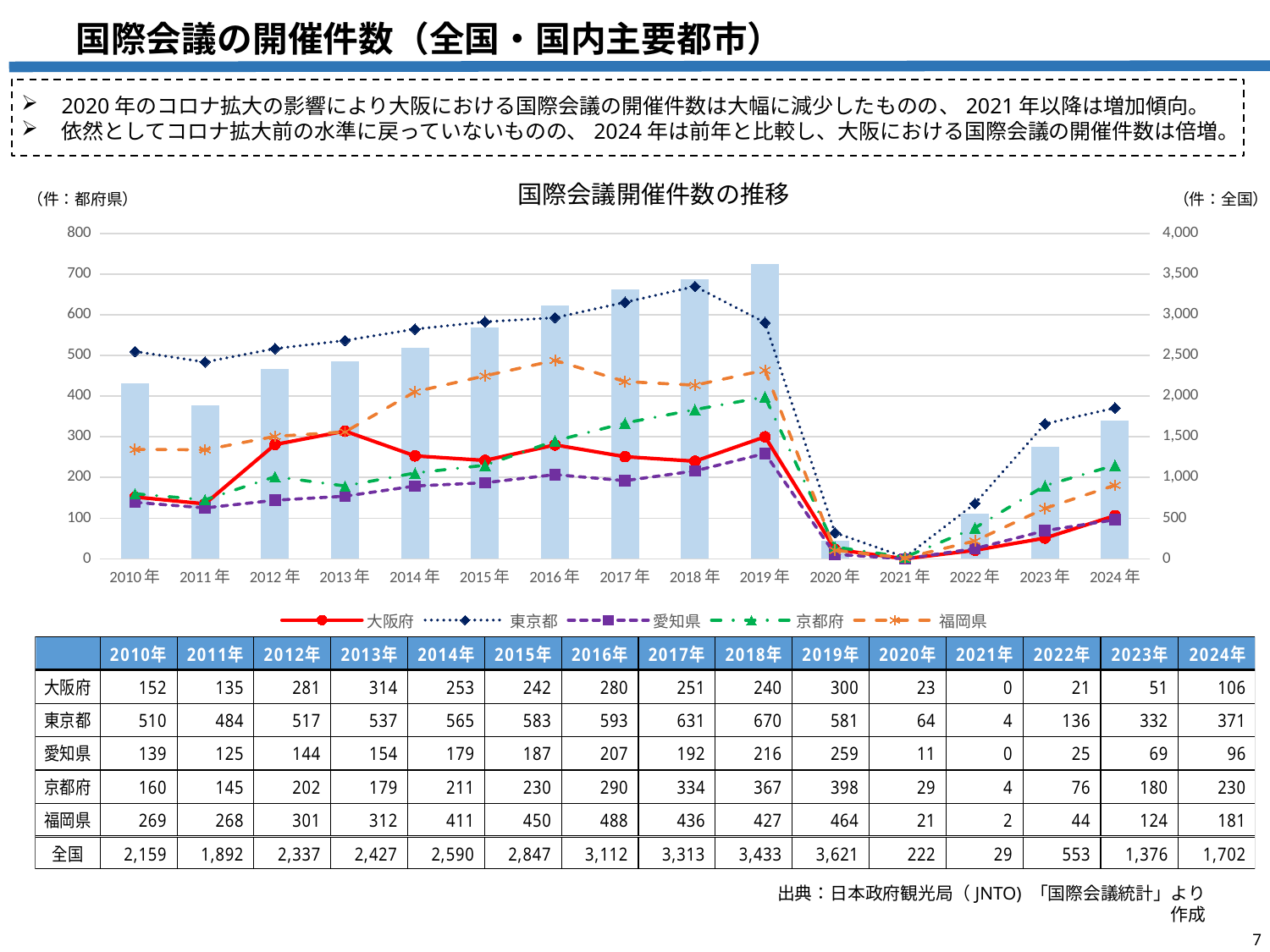
What was the nationwide (全国) number of international conferences in 2019年? 3,621 Did the 東京都 value rise or fall from 2021年 to 2024年? rise Which was larger in 2013年, the value for 大阪府 or the value for 福岡県? 大阪府 What kind of chart is used to show the 全国 values? bar chart What is the title of the chart? 国際会議開催件数の推移 Is the 全国 bar for 2016年 greater or less than 3,000? greater How many years are shown on the x axis of the chart? 15 What is the difference between the 東京都 and 大阪府 values in 2024年? 265 Which prefecture had the lowest number of international conferences in 2019年? 愛知県 What was the number of international conferences held in 大阪府 in 2024年? 106 Which prefecture had the highest number of international conferences in 2018年? 東京都 How many series does the chart legend list? 5